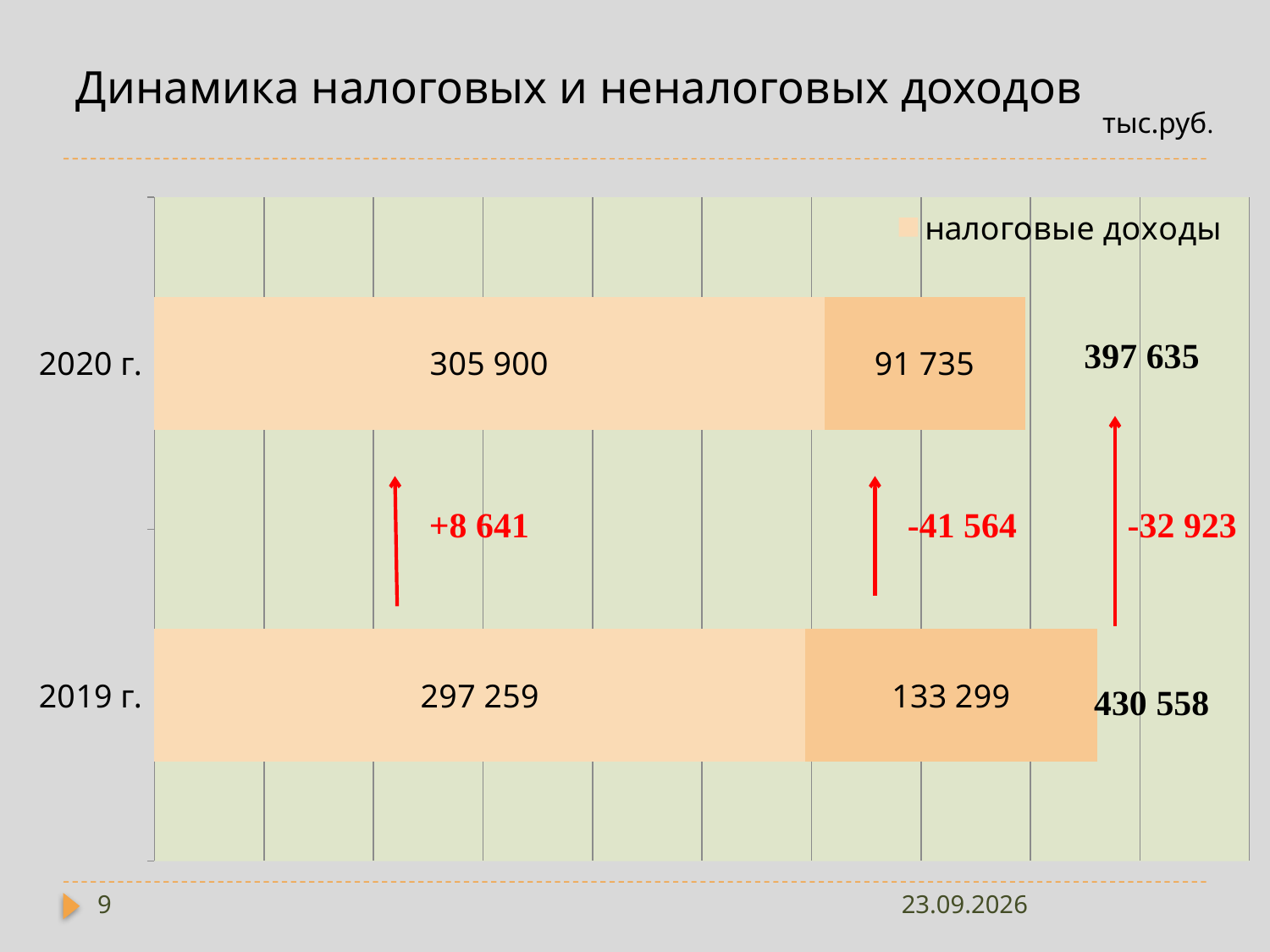
What is the value of the darker (second) segment of the 2020 г. bar? 91 735 By how much did налоговые доходы change from 2019 г. to 2020 г.? +8 641 What is the value of the darker (second) segment of the 2019 г. bar? 133 299 What is the total shown for the 2019 г. bar? 430 558 By how much did the darker (second) segment change from 2019 г. to 2020 г.? -41 564 Which year has the larger total, 2019 г. or 2020 г.? 2019 г. What kind of chart is shown on the slide? Stacked bar chart Which year has the higher value of налоговые доходы? 2020 г. What is the total shown for the 2020 г. bar? 397 635 What is the value of налоговые доходы for 2020 г.? 305 900 How many years (categories) are shown in the chart? 2 What is the value of налоговые доходы for 2019 г.? 297 259